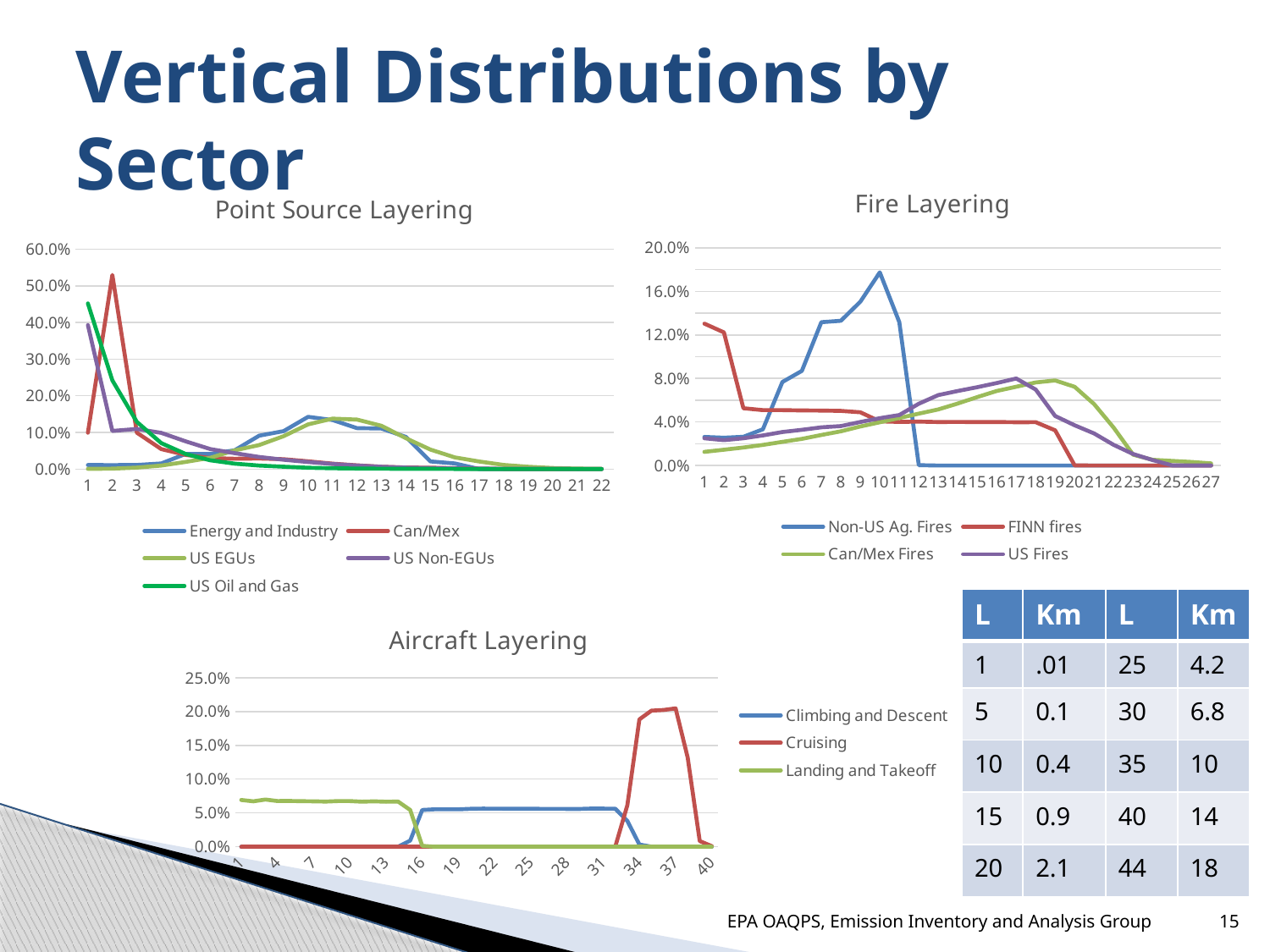
How many series does the legend of the Point Source Layering chart list? 5 How many series does the legend of the Fire Layering chart list? 4 In the Fire Layering chart, at layer 1, which series has the larger value: FINN fires or Non-US Ag. Fires? FINN fires How many series does the legend of the Aircraft Layering chart list? 3 In the Aircraft Layering chart, is the value for Landing and Takeoff at layer 1 greater or less than 10.0%? less In the Point Source Layering chart, how many layers are shown on the x axis? 22 In the Point Source Layering chart, which series reaches the highest peak value? Can/Mex In the Fire Layering chart, how many layers are shown on the x axis? 27 In the Fire Layering chart, which series reaches the highest peak value? Non-US Ag. Fires In the Aircraft Layering chart, which series reaches the highest peak value? Cruising In the Point Source Layering chart, is the value for Can/Mex at layer 2 greater or less than 50.0%? greater What kind of chart is the Point Source Layering chart? line chart